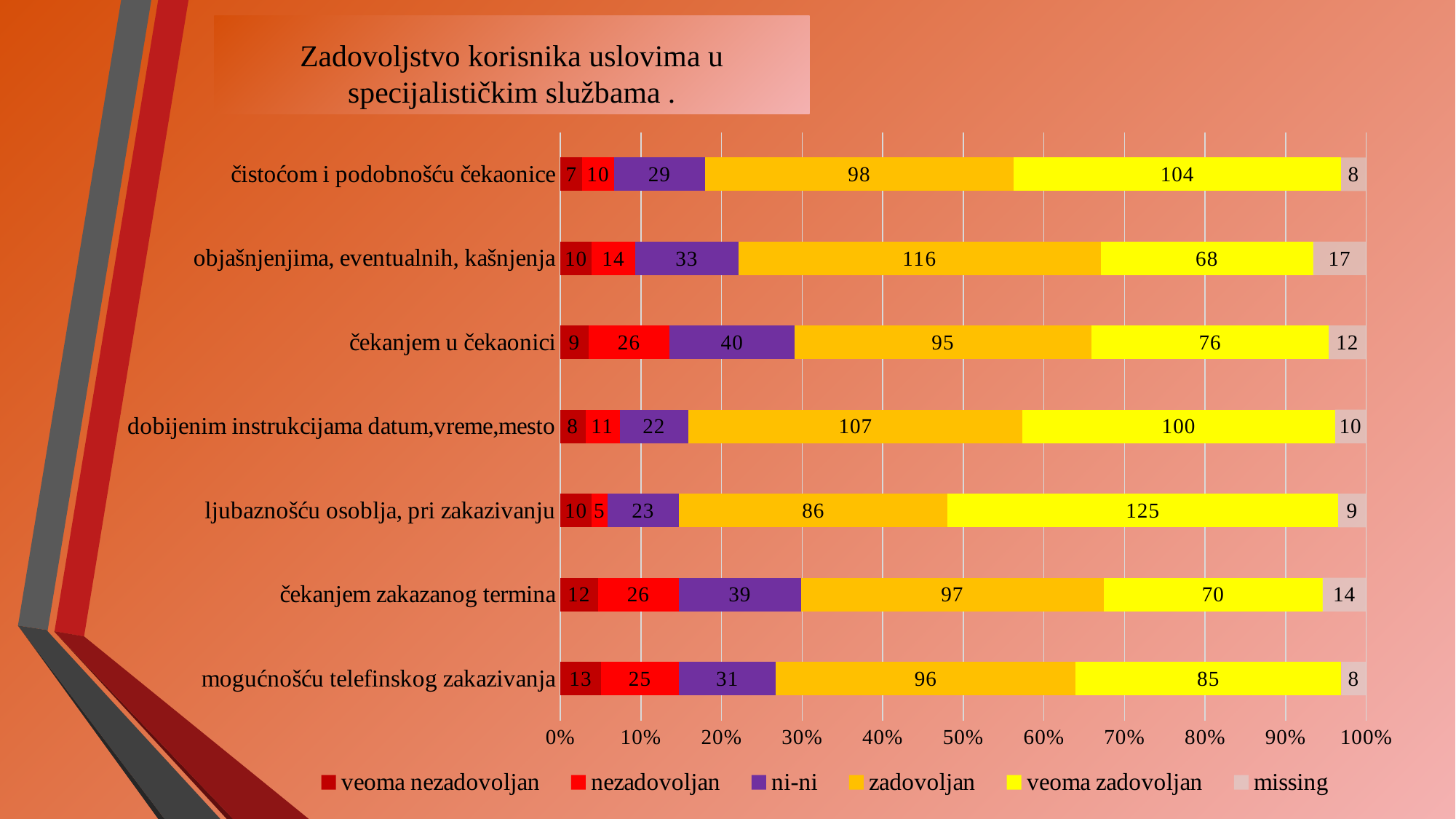
What is the total of the stacked bar for 'čistoćom i podobnošću čekaonice'? 256 What type of chart is shown on the slide? stacked bar chart What is the 'veoma zadovoljan' value for 'ljubaznošću osoblja, pri zakazivanju'? 125 Which is larger: the 'ni-ni' value for 'čekanjem u čekaonici' or for 'mogućnošću telefinskog zakazivanja'? čekanjem u čekaonici Which category has the highest 'veoma zadovoljan' value? ljubaznošću osoblja, pri zakazivanju What is the 'zadovoljan' value for 'objašnjenjima, eventualnih, kašnjenja'? 116 How many categories are plotted on the chart? 7 How many series does the legend list? 6 What is the title of the chart? Zadovoljstvo korisnika uslovima u specijalističkim službama . What is the difference between the 'veoma zadovoljan' values for 'čistoćom i podobnošću čekaonice' and 'čekanjem zakazanog termina'? 34 Which category has the lowest 'nezadovoljan' value? ljubaznošću osoblja, pri zakazivanju What is the 'missing' value for 'čekanjem zakazanog termina'? 14